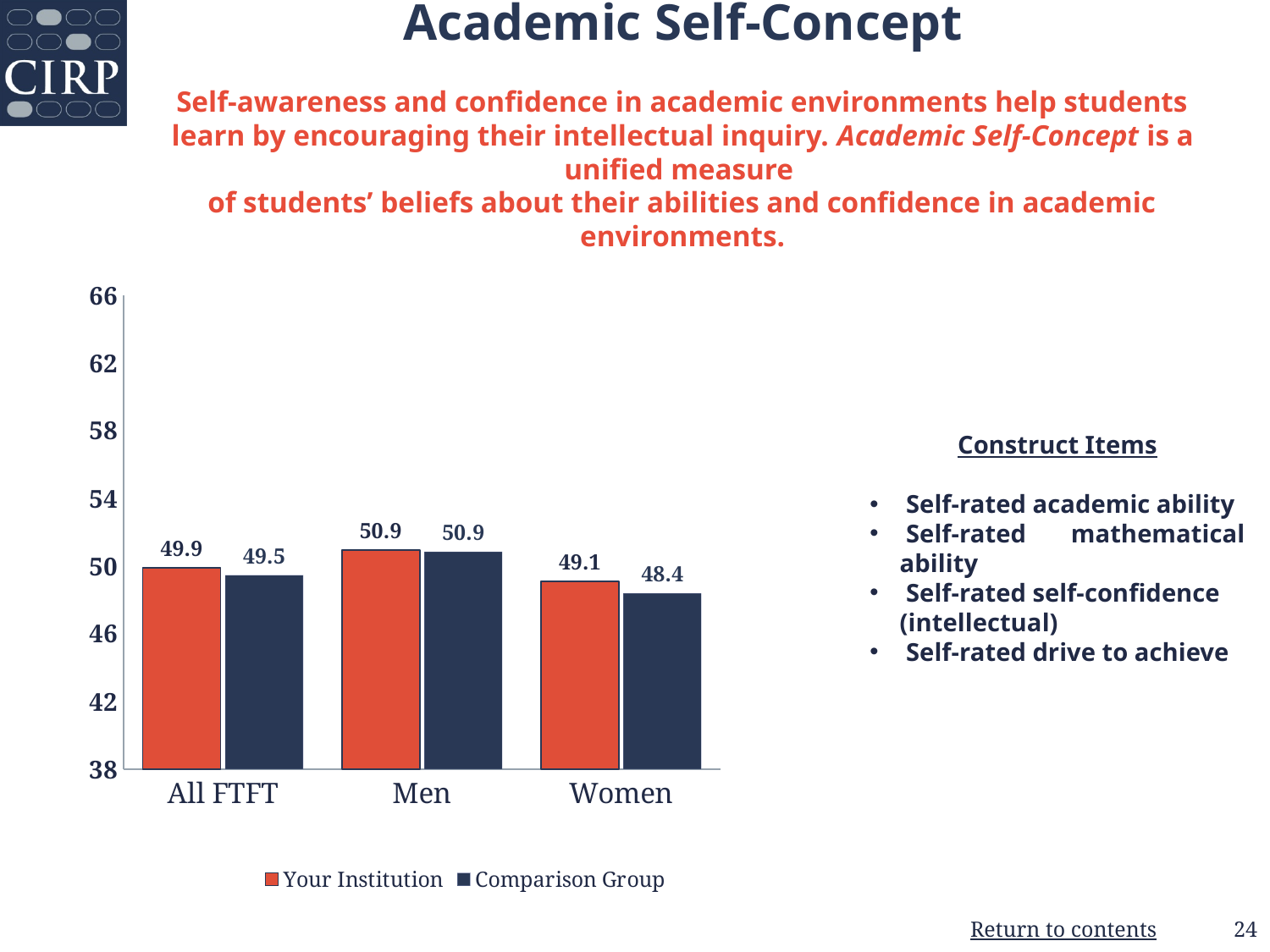
What is the value for Your Institution in the All FTFT category? 49.9 What is the value for the Comparison Group in the Women category? 48.4 What is the difference between the Men and Women values for Your Institution? 1.8 What is the value for Your Institution in the Men category? 50.9 What is the difference between Your Institution and the Comparison Group in the Women category? 0.7 What kind of chart is shown on the slide? bar chart Is the value for the Comparison Group in the Women category greater or less than 50? less How many series does the legend list? 2 Which is larger in the All FTFT category: Your Institution or the Comparison Group? Your Institution Which category has the highest value for the Comparison Group? Men Which category has the lowest value for Your Institution? Women How many categories are shown on the x axis? 3